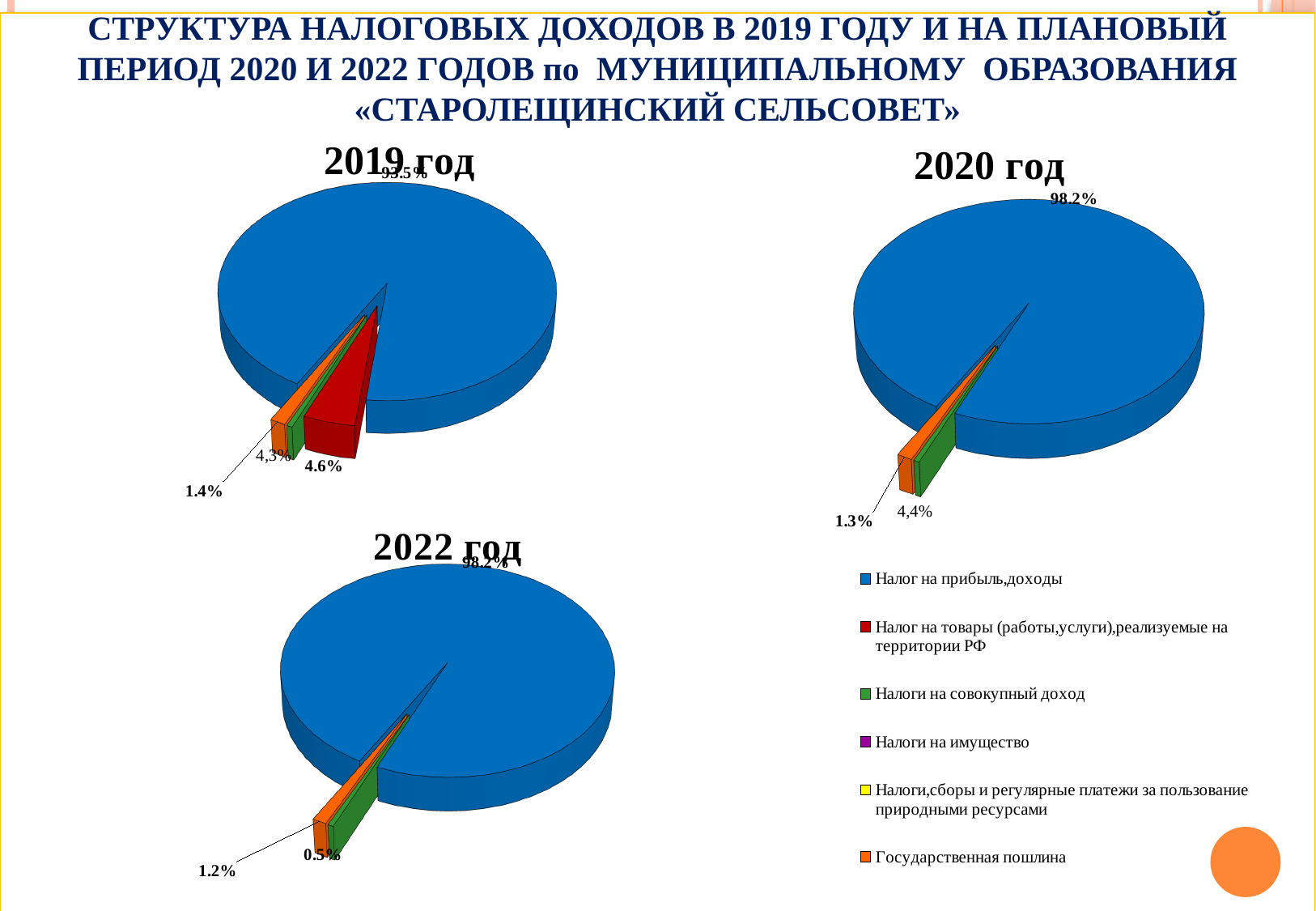
How many pie charts are on the slide? 3 In the 2020 год chart, what share is shown for Налог на прибыль,доходы (the blue slice)? 98.2% In the 2020 год chart, what share is labelled for Государственная пошлина (the orange slice)? 1.3% Which legend entry is shown in red? Налог на товары (работы,услуги),реализуемые на территории РФ What kind of charts are shown on the slide? Pie charts In the 2022 год chart, which category has the largest slice? Налог на прибыль,доходы In the 2022 год chart, what share is labelled for Государственная пошлина (the orange slice)? 1.2% How many entries does the legend list? 6 In the 2022 год chart, what share is shown for Налог на прибыль,доходы (the blue slice)? 98.2% In the 2019 год chart, what share is labelled on the red slice (Налог на товары (работы,услуги),реализуемые на территории РФ)? 4.6% In the 2019 год chart, what share is labelled for Государственная пошлина (the orange slice)? 1.4%